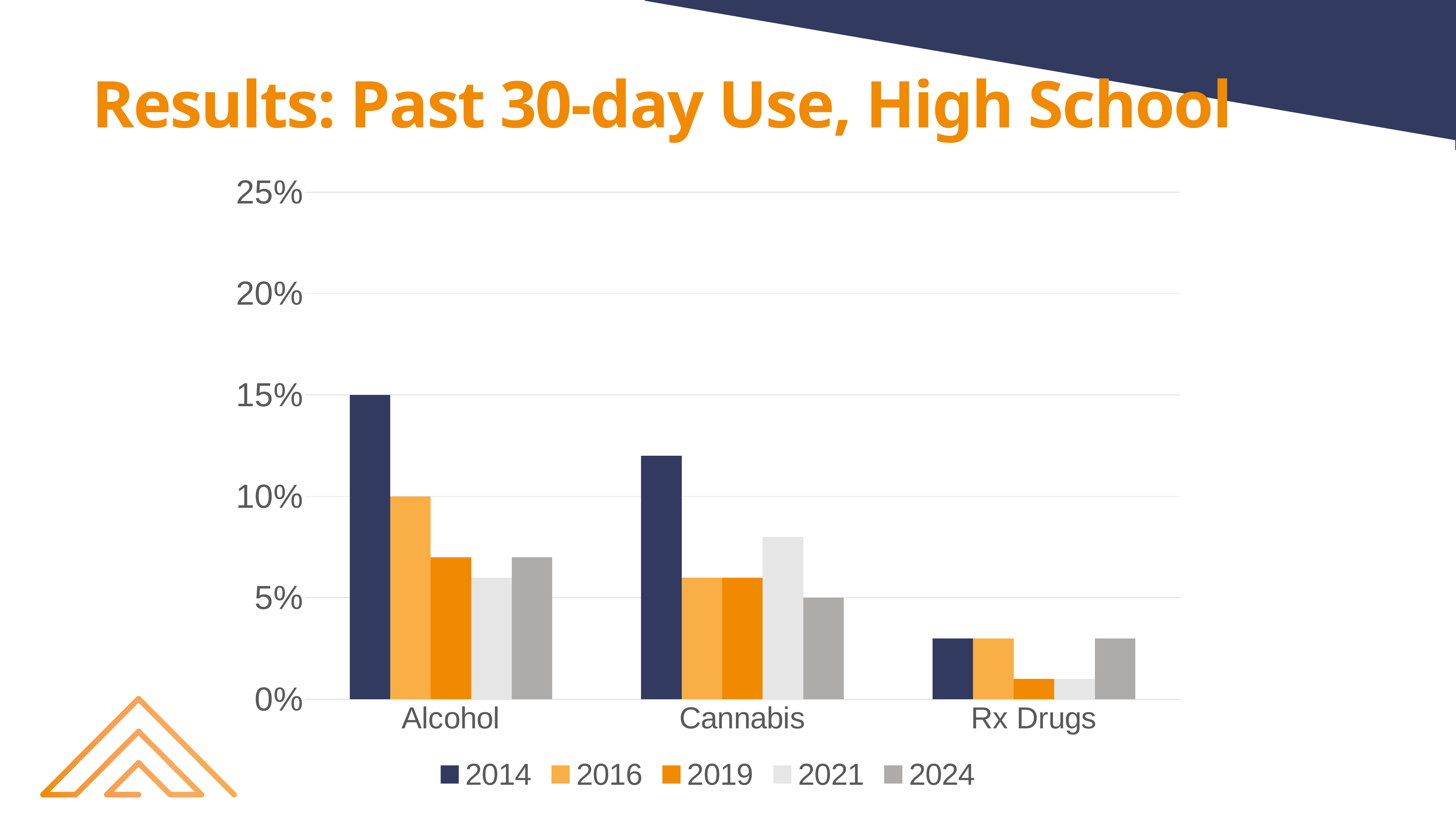
Is the value for Rx Drugs in 2014 greater or less than 5%? less Is the value for Cannabis in 2014 greater or less than 10%? greater What is the value for Alcohol in 2016? 10% How many categories are shown on the x axis? 3 What is the value for Alcohol in 2014? 15% Do the Alcohol values rise or fall from 2014 to 2019? Fall How many series does the legend list? 5 What is the difference between the Alcohol values for 2014 and 2016? 5% Which is larger for Cannabis: the 2021 value or the 2024 value? 2021 What is the value for Cannabis in 2024? 5% What type of chart is shown on the slide? Bar chart Which category has the highest bar in the chart? Alcohol